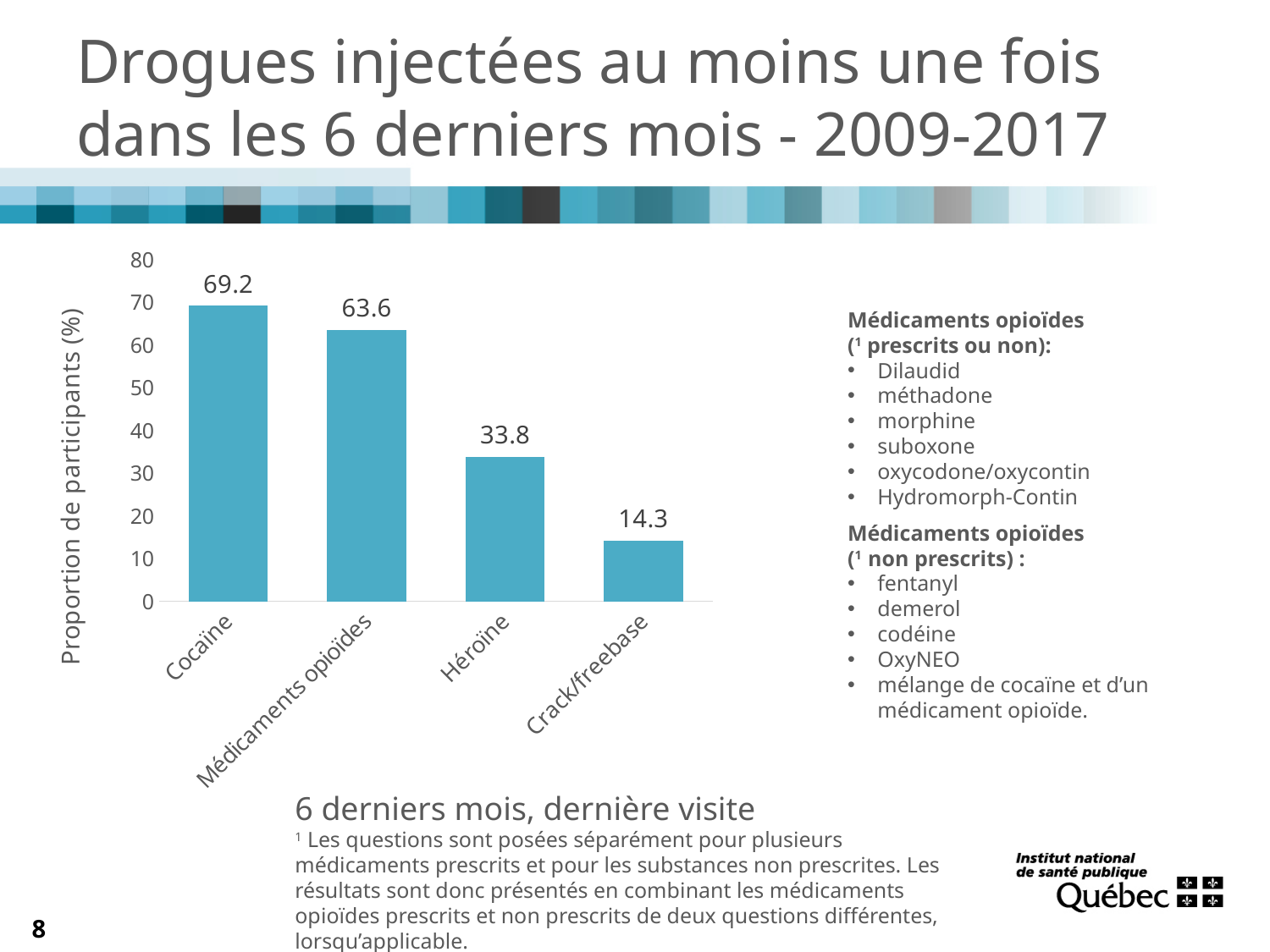
What is the difference between the values for Héroïne and Crack/freebase? 19.5 What is the value for Cocaïne? 69.2 What kind of chart is shown on the slide? Bar chart What is the value for Médicaments opioïdes? 63.6 How many categories are shown on the chart? 4 What is the value for Héroïne? 33.8 What is the value for Crack/freebase? 14.3 Which is larger, the value for Héroïne or the value for Crack/freebase? Héroïne Which category has the lowest value? Crack/freebase Which category has the highest value? Cocaïne What is the label of the vertical axis? Proportion de participants (%) What is the difference between the values for Cocaïne and Médicaments opioïdes? 5.6